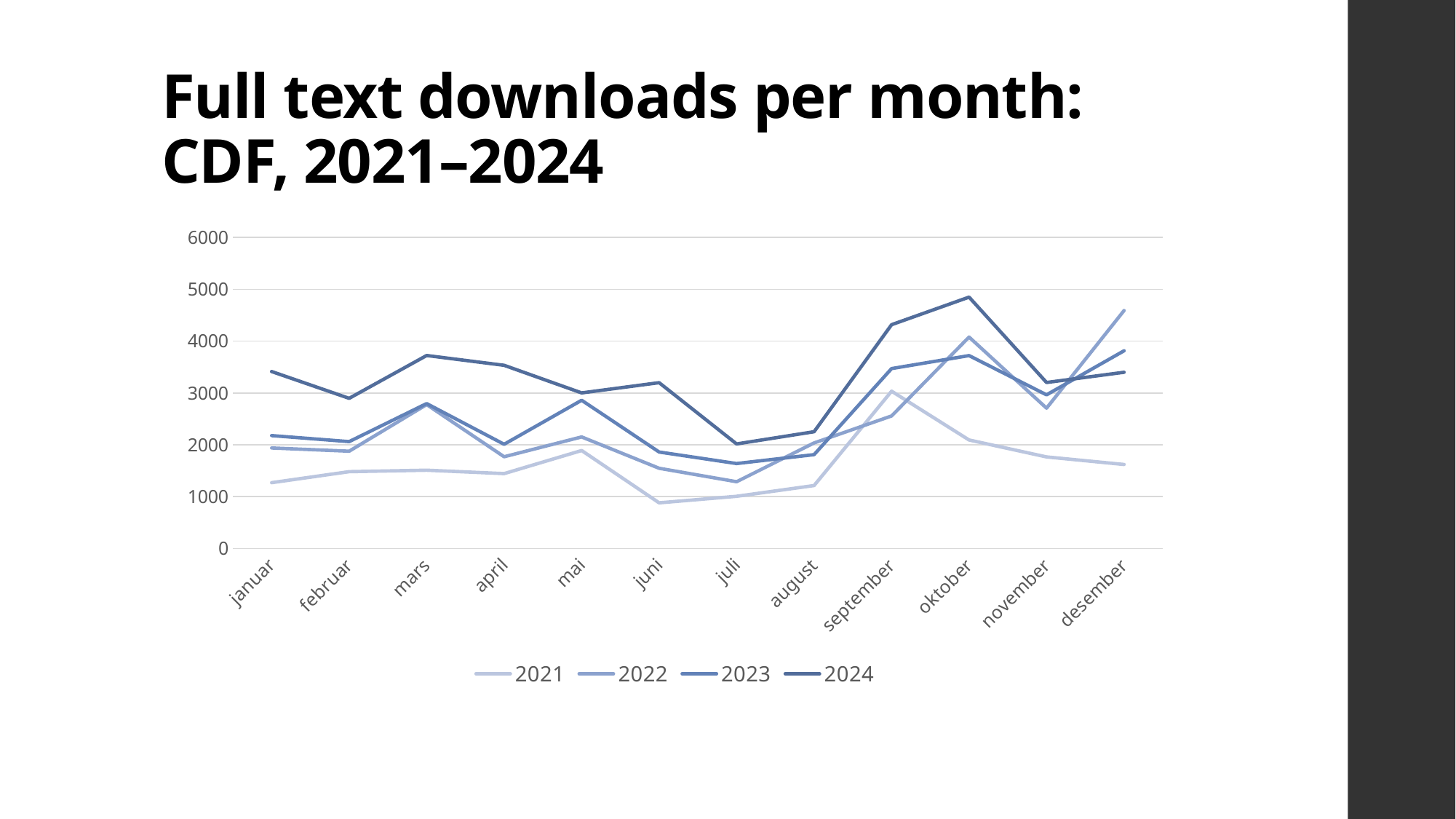
Which series has the highest value in januar? 2024 In januar, which series has the higher value, 2021 or 2024? 2024 Is the value for 2021 in juni greater or less than 1000? less Is the value for 2022 in desember greater or less than 4000? greater What is the title of the chart on the slide? Full text downloads per month: CDF, 2021–2024 How many series does the legend list? 4 In which month does the 2021 series reach its lowest value? juni In which month does the 2024 series reach its highest value? oktober Is the value for 2024 in oktober greater or less than 4000? greater What kind of chart is shown on the slide? line chart How many months are shown along the x axis? 12 Does the 2021 series rise or fall from september to desember? fall